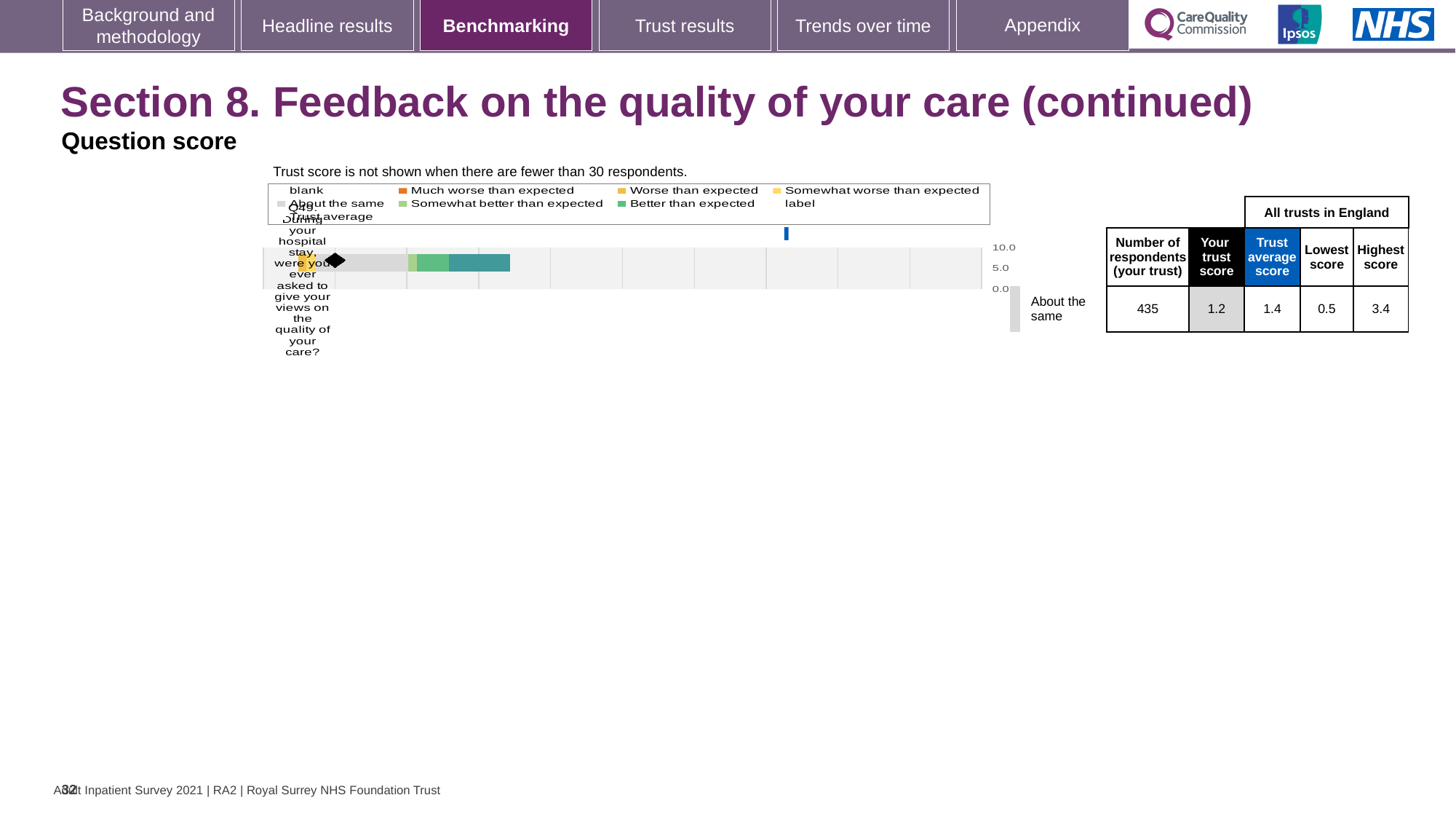
What is the lowest score among all trusts in England shown in the table? 0.5 What is the number of respondents for your trust shown in the table next to the chart? 435 How many questions (categories) are plotted in the bar chart? 1 What is the highest score among all trusts in England shown in the table? 3.4 Which is larger, your trust score or the trust average score? Trust average score What benchmark category is shown for Q49 next to the chart? About the same What kind of chart is shown on the slide? Bar chart What colour does the legend use for 'Much worse than expected'? Orange What is the 'Trust average score' for all trusts in England shown in the table? 1.4 Which question number is plotted in the bar chart? Q49 What is 'Your trust score' shown in the table next to the chart? 1.2 What is the difference between the highest score and the lowest score in the table? 2.9